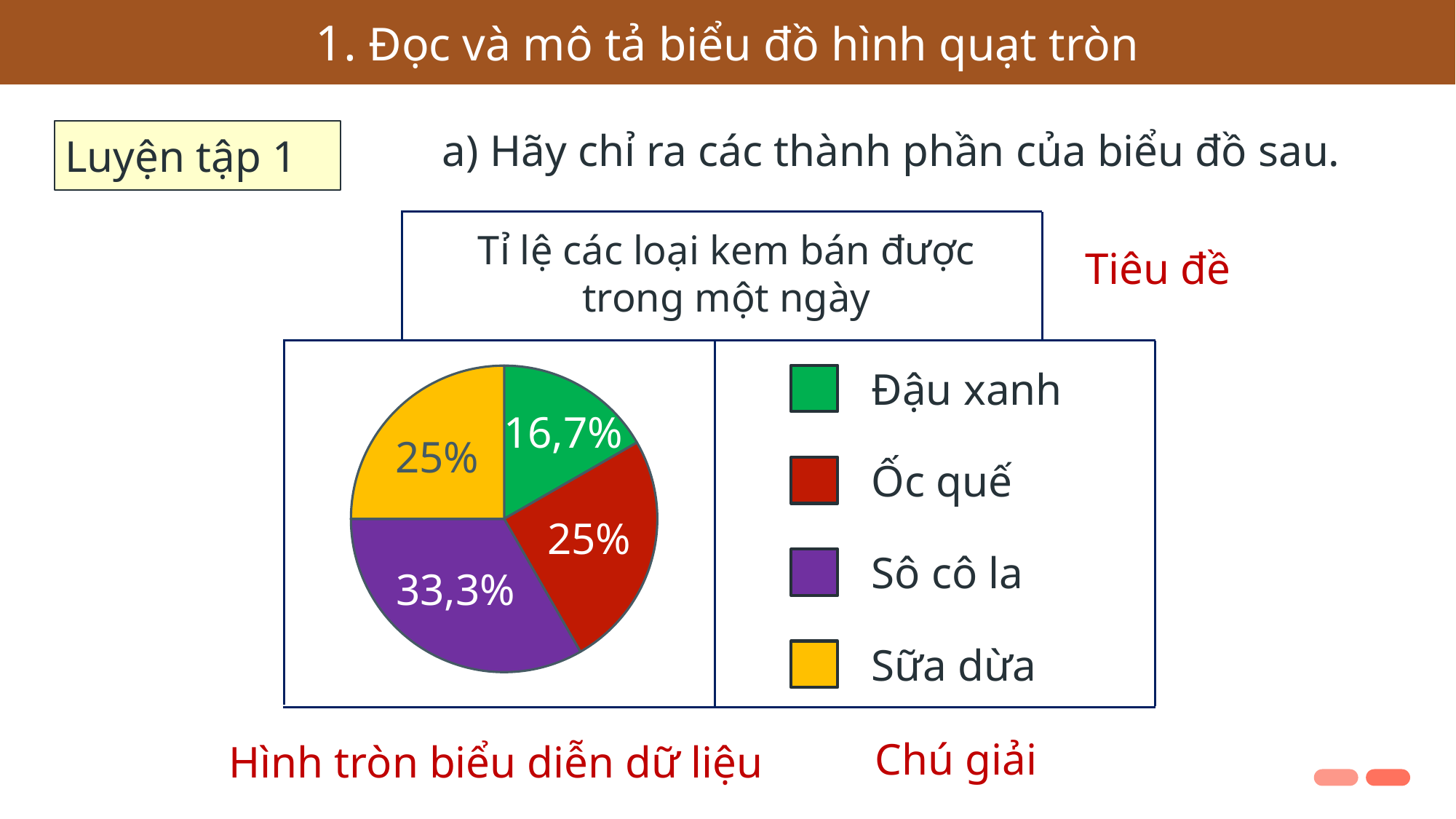
What is the difference between the shares of Sô cô la and Đậu xanh? 16,6% How many categories are shown in the pie chart? 4 What percentage is shown for Ốc quế? 25% Which type of ice cream has the largest share of the pie? Sô cô la Which is larger, the share for Sô cô la or the share for Ốc quế? Sô cô la Which colour represents Sữa dừa in the legend? Yellow What is the value shown for Đậu xanh? 16,7% What share of the pie does Sữa dừa represent? 25% What kind of chart is shown on the slide? Pie chart What share of the pie does Sô cô la represent? 33,3% What is the title of the chart? Tỉ lệ các loại kem bán được trong một ngày Which type of ice cream has the smallest share of the pie? Đậu xanh